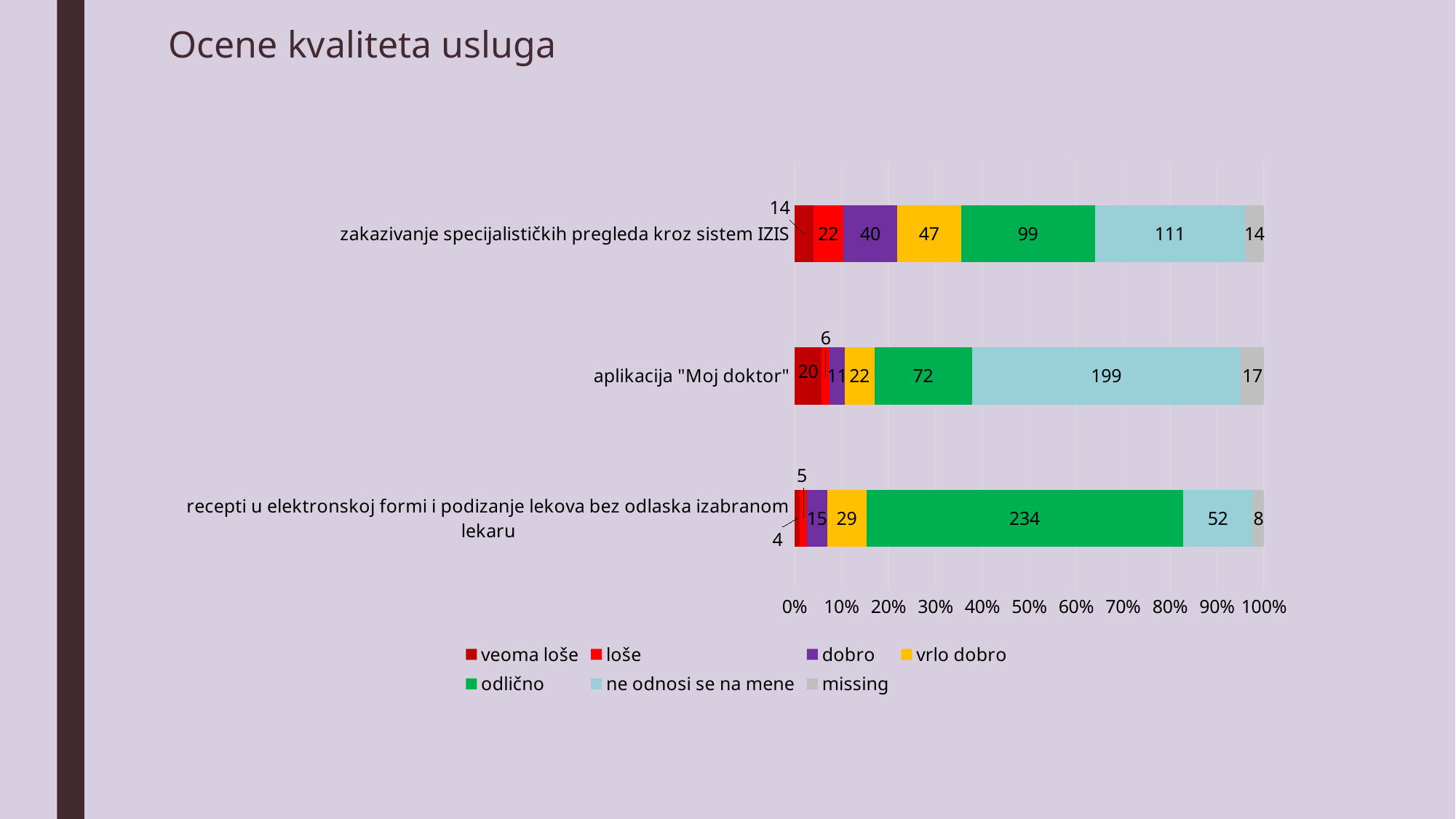
What kind of chart is shown on the slide? stacked bar chart What is the title of the slide containing the chart? Ocene kvaliteta usluga Which category has the highest "odlično" value? recepti u elektronskoj formi i podizanje lekova bez odlaska izabranom lekaru Which is larger: the "dobro" value for "zakazivanje specijalističkih pregleda kroz sistem IZIS" or for "aplikacija "Moj doktor""? zakazivanje specijalističkih pregleda kroz sistem IZIS What is the value of "missing" for "aplikacija "Moj doktor""? 17 What is the value of "odlično" for "recepti u elektronskoj formi i podizanje lekova bez odlaska izabranom lekaru"? 234 What is the value of "vrlo dobro" for "zakazivanje specijalističkih pregleda kroz sistem IZIS"? 47 What is the value of "ne odnosi se na mene" for "aplikacija "Moj doktor""? 199 What is the difference between the "odlično" values for "zakazivanje specijalističkih pregleda kroz sistem IZIS" and "aplikacija "Moj doktor""? 27 How many series does the legend list? 7 How many categories (services) are plotted on the chart? 3 Which category has the lowest "ne odnosi se na mene" value? recepti u elektronskoj formi i podizanje lekova bez odlaska izabranom lekaru